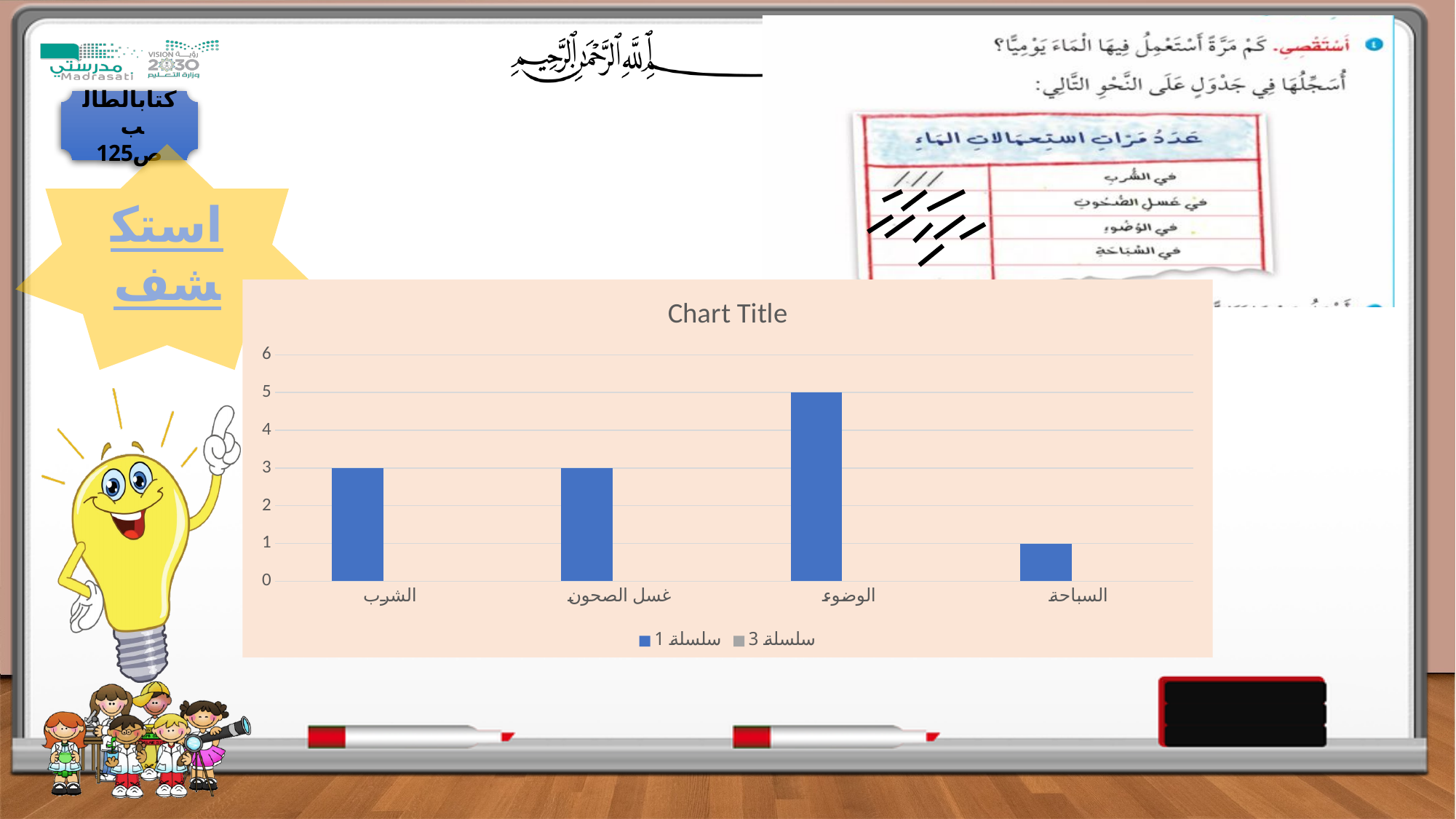
Is the value for الوضوء greater or less than 4? greater What is the value for السباحة? 1 Which is larger, the value for غسل الصحون or the value for السباحة? غسل الصحون What is the title of the chart? Chart Title What is the value for الوضوء? 5 Which category has the lowest value? السباحة How many series does the chart legend list? 2 Which category has the highest value? الوضوء What type of chart is shown on the slide? bar chart What is the difference between the values for الوضوء and السباحة? 4 What is the value for الشرب? 3 How many categories are shown on the x axis of the chart? 4